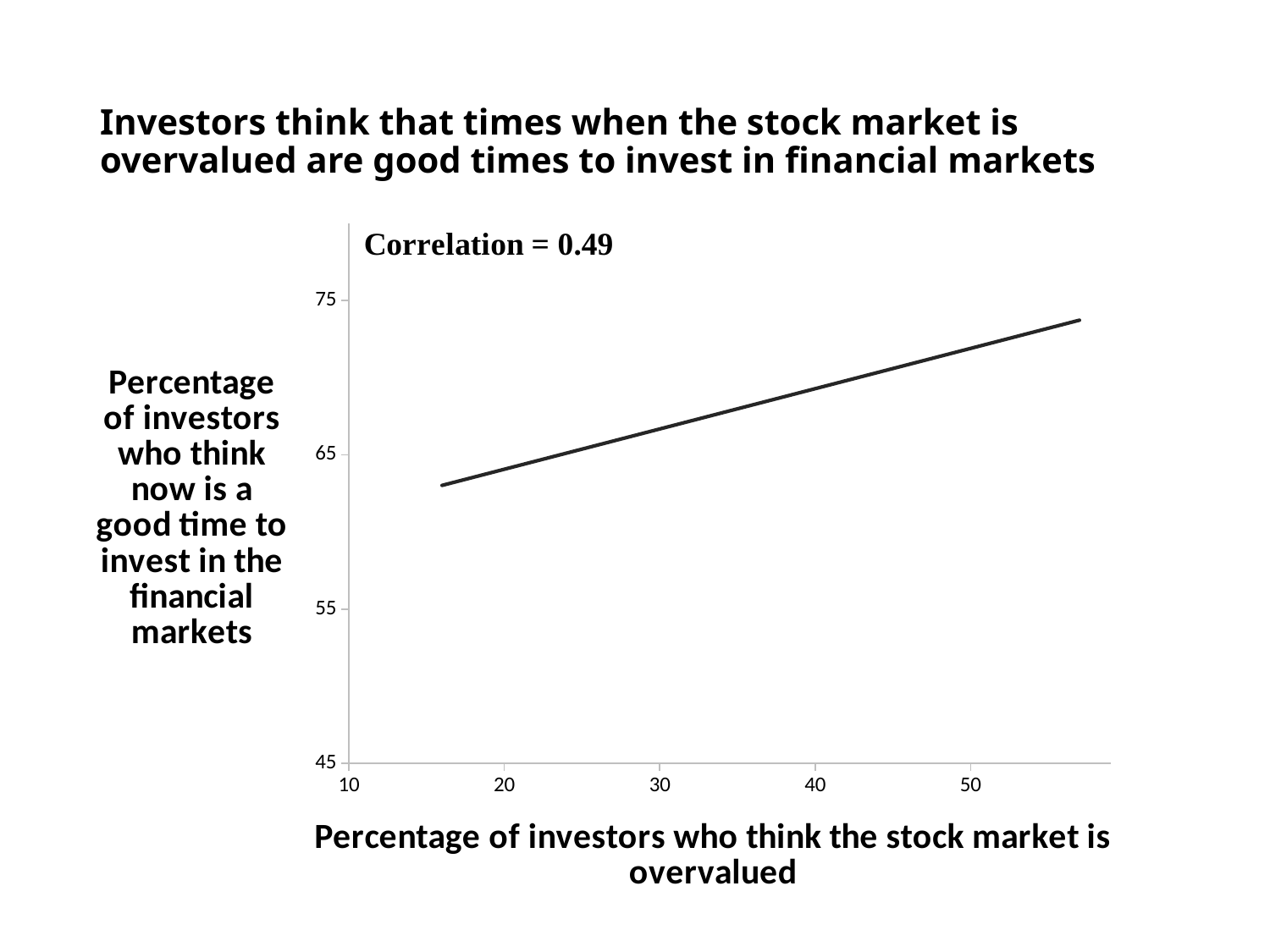
Is the value of the line at an x value of 40 greater or less than 75? less Does the line rise or fall as the percentage of investors who think the stock market is overvalued increases? rises What is the label of the x axis? Percentage of investors who think the stock market is overvalued Is the value of the line at an x value of 50 greater or less than 75? less What correlation value is printed on the chart? 0.49 Is the value of the line at an x value of 40 greater or less than 65? greater Is the line higher at an x value of 50 or at an x value of 20? 50 How many lines are plotted on the chart? 1 What kind of chart is shown on the slide? line chart